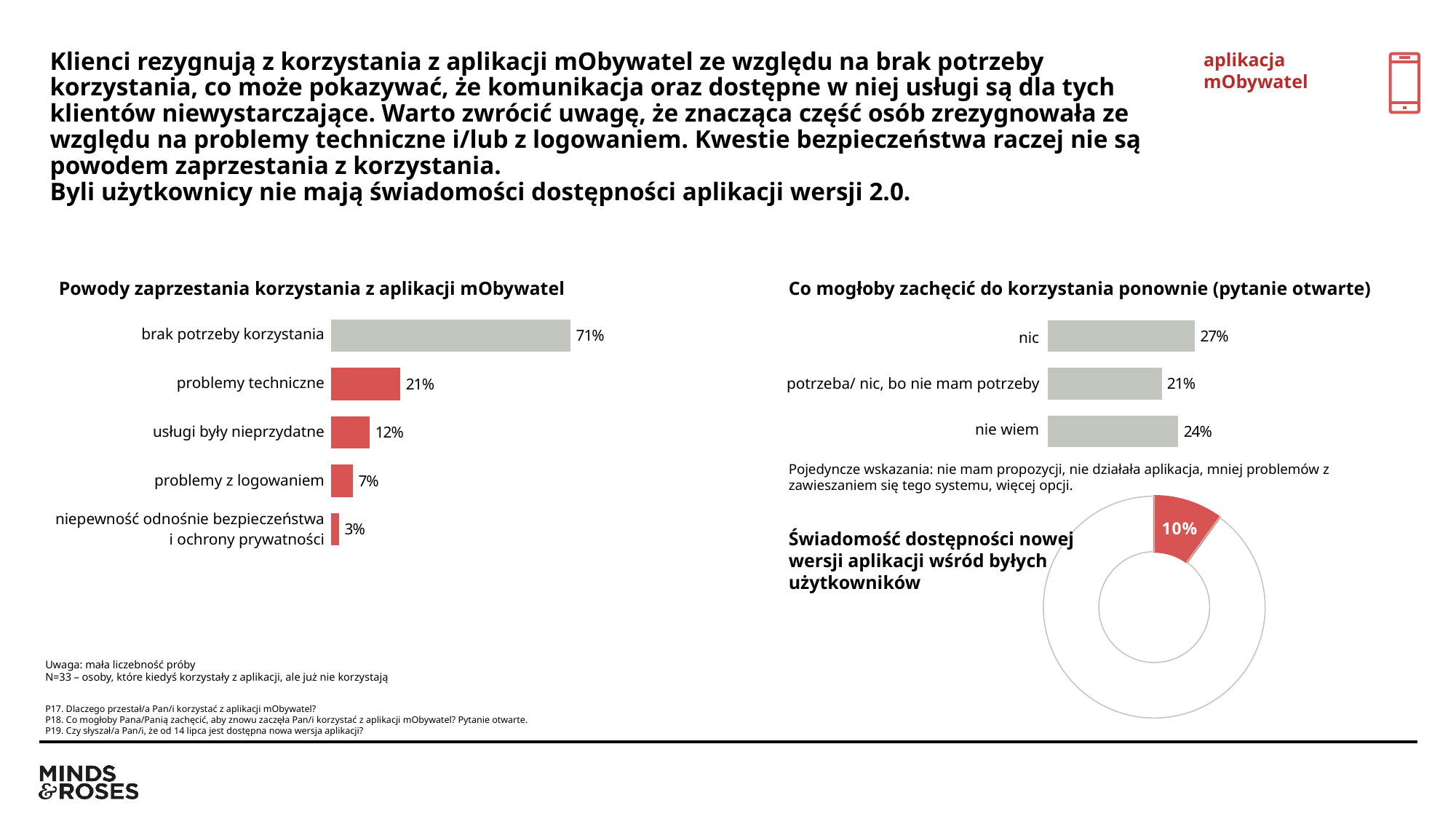
In the chart 'Powody zaprzestania korzystania z aplikacji mObywatel', how many categories are shown? 5 In the chart 'Co mogłoby zachęcić do korzystania ponownie (pytanie otwarte)', what is the value for 'nie wiem'? 24% In the chart 'Powody zaprzestania korzystania z aplikacji mObywatel', what is the value for 'problemy z logowaniem'? 7% In the chart 'Powody zaprzestania korzystania z aplikacji mObywatel', what is the value for 'problemy techniczne'? 21% In the doughnut chart 'Świadomość dostępności nowej wersji aplikacji wśród byłych użytkowników', what share is shown for the highlighted slice? 10% In the chart 'Powody zaprzestania korzystania z aplikacji mObywatel', what is the difference between 'brak potrzeby korzystania' and 'problemy techniczne'? 50% In the chart 'Co mogłoby zachęcić do korzystania ponownie (pytanie otwarte)', how many categories are shown? 3 What kind of chart is 'Co mogłoby zachęcić do korzystania ponownie (pytanie otwarte)'? bar chart In the chart 'Co mogłoby zachęcić do korzystania ponownie (pytanie otwarte)', which category has the highest value? nic In the chart 'Powody zaprzestania korzystania z aplikacji mObywatel', which category has the highest value? brak potrzeby korzystania In the chart 'Powody zaprzestania korzystania z aplikacji mObywatel', which category has the lowest value? niepewność odnośnie bezpieczeństwa i ochrony prywatności In the chart 'Co mogłoby zachęcić do korzystania ponownie (pytanie otwarte)', which is larger: 'nie wiem' or 'potrzeba/ nic, bo nie mam potrzeby'? nie wiem